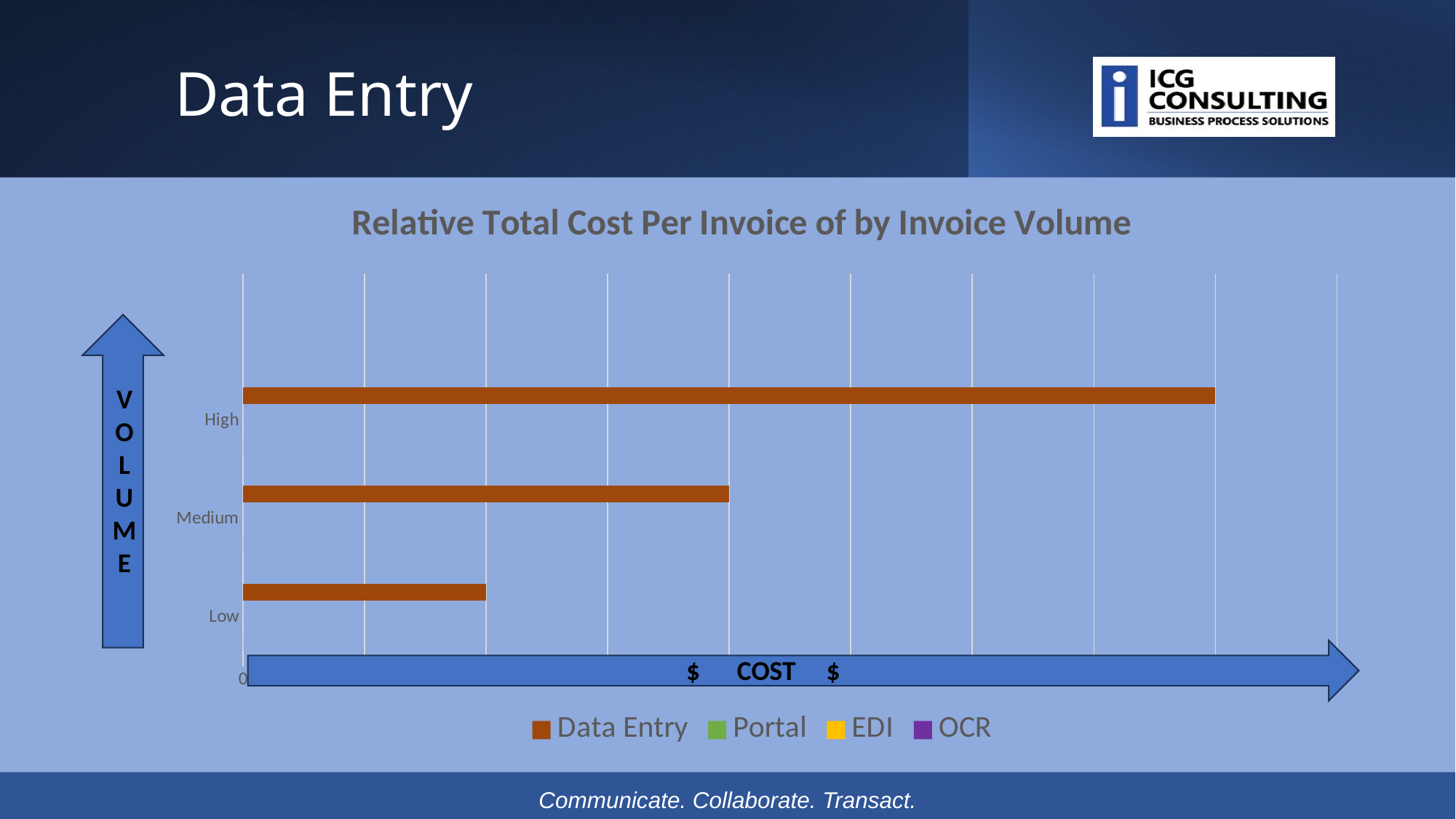
Which volume category has the longest Data Entry bar? High What kind of chart is shown on the slide? bar chart Which volume category has the shortest Data Entry bar? Low How many series does the chart legend list? 4 Which has the larger Data Entry bar, High or Medium volume? High What is the title of the chart? Relative Total Cost Per Invoice of by Invoice Volume Which series is the only one with visible bars on the chart? Data Entry Do the Data Entry bars get longer or shorter going from Low to High volume? longer Which series in the legend is shown in orange-brown? Data Entry How many volume categories are shown on the chart's vertical axis? 3 Which has the larger Data Entry bar, Medium or Low volume? Medium